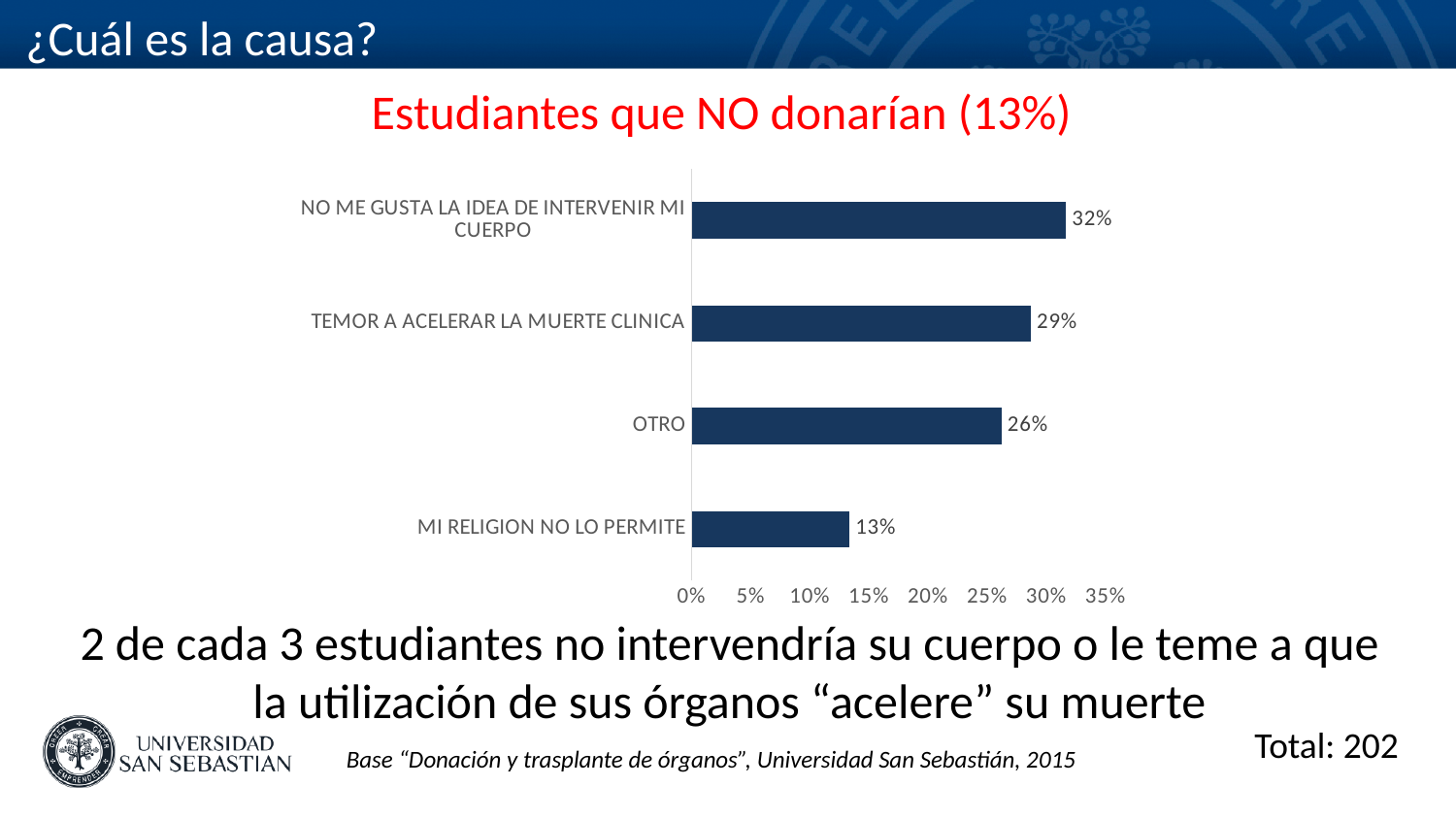
What is the value for TEMOR A ACELERAR LA MUERTE CLINICA? 29% What is the value for MI RELIGION NO LO PERMITE? 13% What kind of chart is shown on the slide? Bar chart What is the value for NO ME GUSTA LA IDEA DE INTERVENIR MI CUERPO? 32% What is the difference between the values for TEMOR A ACELERAR LA MUERTE CLINICA and OTRO? 3% Which is larger, the value for OTRO or the value for MI RELIGION NO LO PERMITE? OTRO Which category has the highest value? NO ME GUSTA LA IDEA DE INTERVENIR MI CUERPO What is the title of the chart? Estudiantes que NO donarían (13%) Which category has the lowest value? MI RELIGION NO LO PERMITE How many categories are shown in the chart? 4 What is the value for OTRO? 26% What is the difference between the values for NO ME GUSTA LA IDEA DE INTERVENIR MI CUERPO and MI RELIGION NO LO PERMITE? 19%